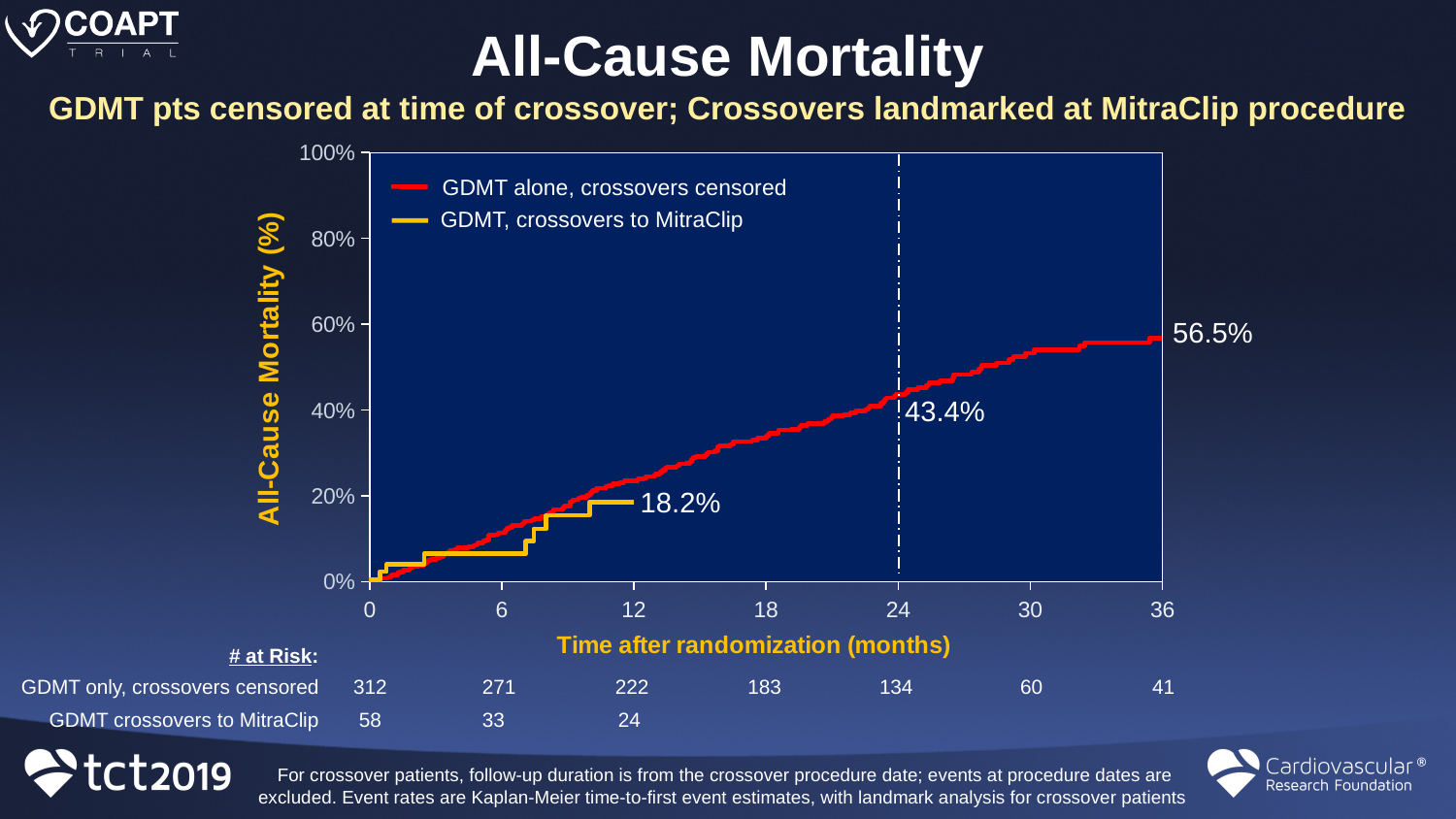
How many series does the legend list? 2 How many patients in the GDMT only, crossovers censored group were at risk at 24 months? 134 Is the 24-month mortality for the GDMT alone, crossovers censored group greater or less than 40%? greater Is the labelled mortality for the GDMT, crossovers to MitraClip curve greater or less than 20%? less What is the all-cause mortality for the GDMT alone, crossovers censored group at 36 months? 56.5% Which colour represents the GDMT, crossovers to MitraClip series? Yellow What is the all-cause mortality labelled for the GDMT, crossovers to MitraClip curve? 18.2% How many patients in the GDMT crossovers to MitraClip group were at risk at 0 months? 58 What is the all-cause mortality for the GDMT alone, crossovers censored group at 24 months, where the dashed vertical line is drawn? 43.4% Does the all-cause mortality for the GDMT alone, crossovers censored group rise or fall over time after randomization? rise What is the difference between the 36-month and 24-month mortality values labelled on the GDMT alone, crossovers censored curve? 13.1% What is the label of the x axis? Time after randomization (months)